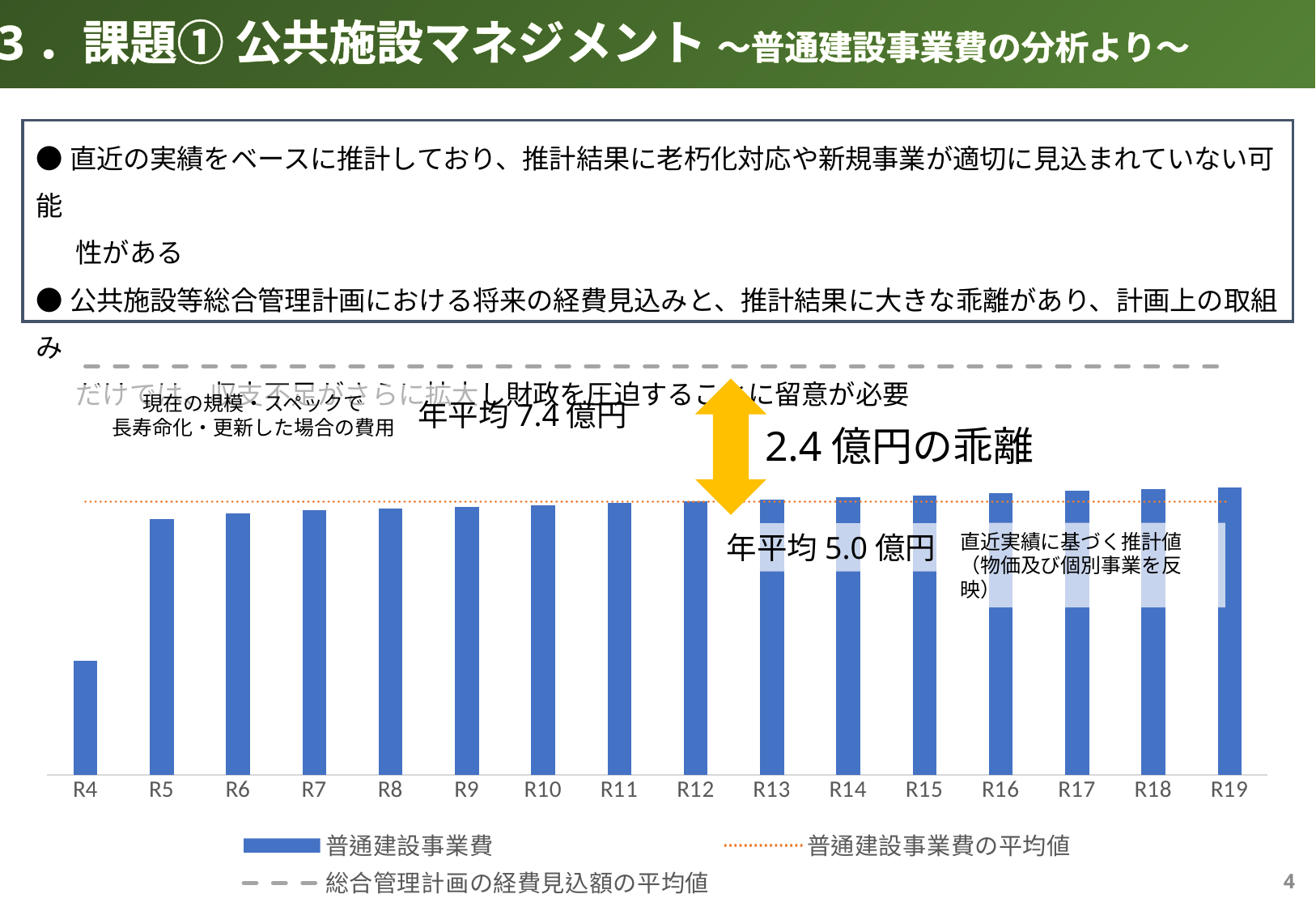
What is the first legend entry of the chart? 普通建設事業費 What colour are the bars in the chart? blue What kind of chart is shown on the slide? combination bar and line chart Which is larger, the average of 総合管理計画の経費見込額 or the average of 普通建設事業費? 総合管理計画の経費見込額の平均値 What is the annual average of 総合管理計画の経費見込額 shown on the chart? 年平均 7.4 億円 How many entries does the chart's legend list? 3 Which is larger, the bar for R4 or the bar for R5? R5 Do the bar values generally rise or fall from R4 to R19? rise What is the gap (乖離) between the two average lines shown on the chart? 2.4 億円 What is the annual average of 普通建設事業費 shown on the chart? 年平均 5.0 億円 Which fiscal year has the lowest bar in the chart? R4 How many categories (fiscal years) are shown on the x axis of the chart? 16